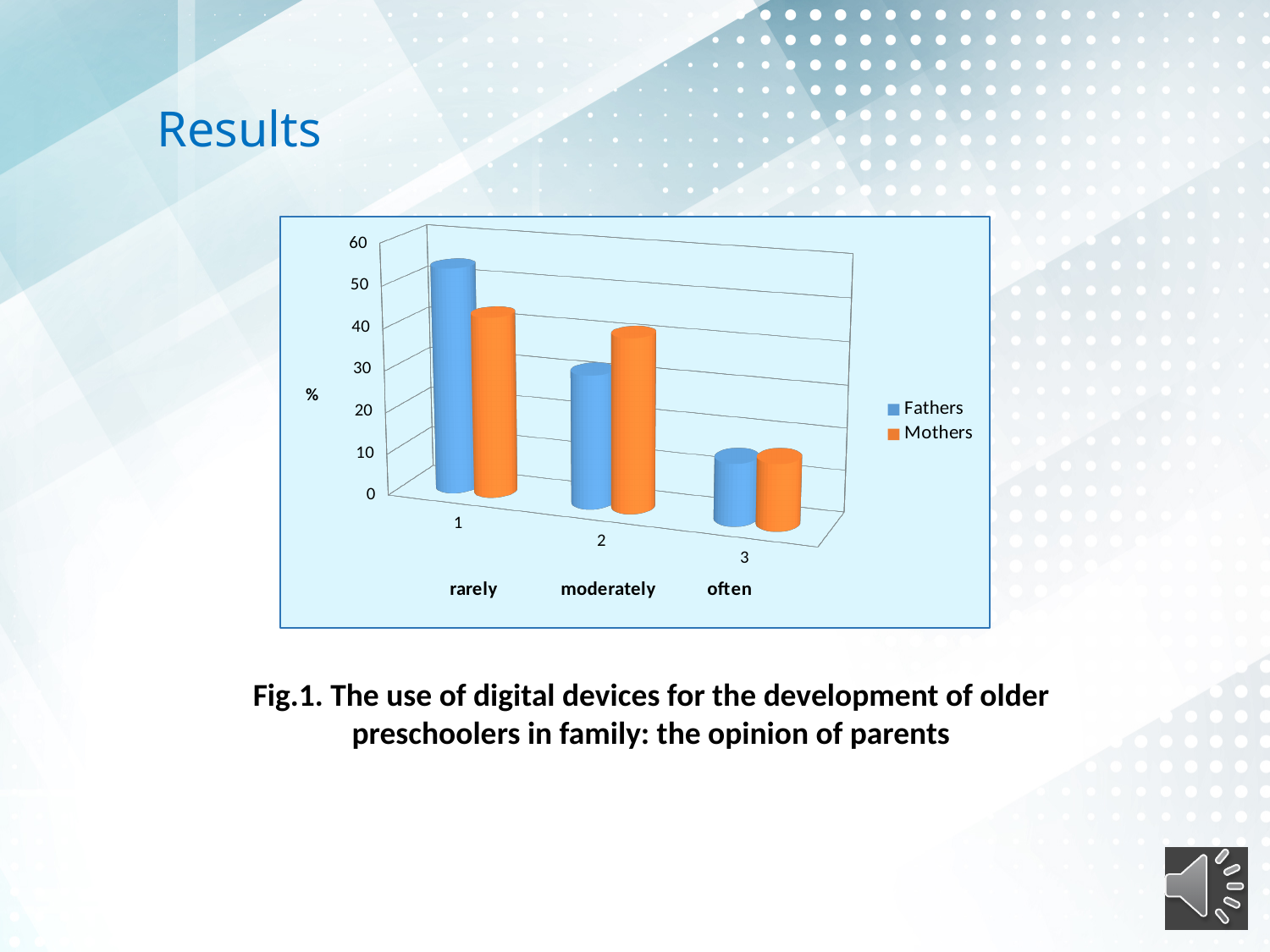
For the 'moderately' category, which is larger: Fathers or Mothers? Mothers For which category is the Fathers value highest? rarely Is the Fathers value for 'rarely' greater or less than 40? greater How many series does the legend list? 2 For which category is the Mothers value lowest? often Do the Fathers values rise or fall from 'rarely' to 'often'? fall Which series are listed in the legend? Fathers and Mothers For the 'rarely' category, which is larger: Fathers or Mothers? Fathers What kind of chart is shown on the slide? bar chart How many categories are shown on the x axis? 3 What label is shown on the vertical axis? % Is the Mothers value for 'often' greater or less than 20? less